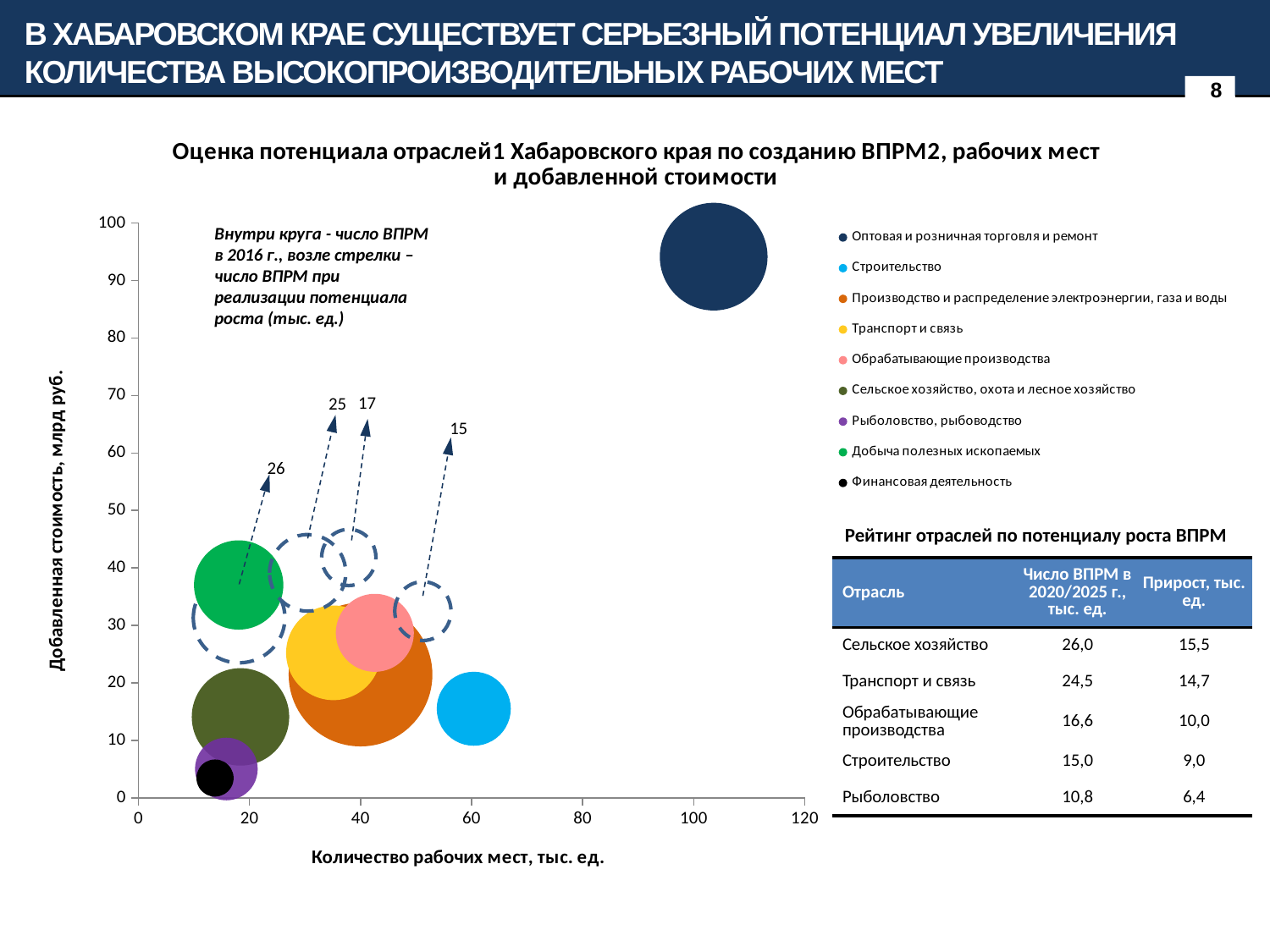
What is the label of the horizontal axis of the chart? Количество рабочих мест, тыс. ед. What is the label of the vertical axis of the chart? Добавленная стоимость, млрд руб. Is the number of jobs for Строительство greater or less than 40 тыс. ед.? greater Which has a higher added value: Оптовая и розничная торговля и ремонт or Строительство? Оптовая и розничная торговля и ремонт How many series does the chart legend list? 9 What is the largest value printed next to the dashed arrows on the chart? 26 Is the added value for Финансовая деятельность greater or less than 10 млрд руб.? less Is the added value for Строительство greater or less than 20 млрд руб.? less Which series is positioned furthest to the right on the horizontal axis? Оптовая и розничная торговля и ремонт Which series has the highest added value (highest position on the vertical axis)? Оптовая и розничная торговля и ремонт What kind of chart is shown on the slide? Bubble chart